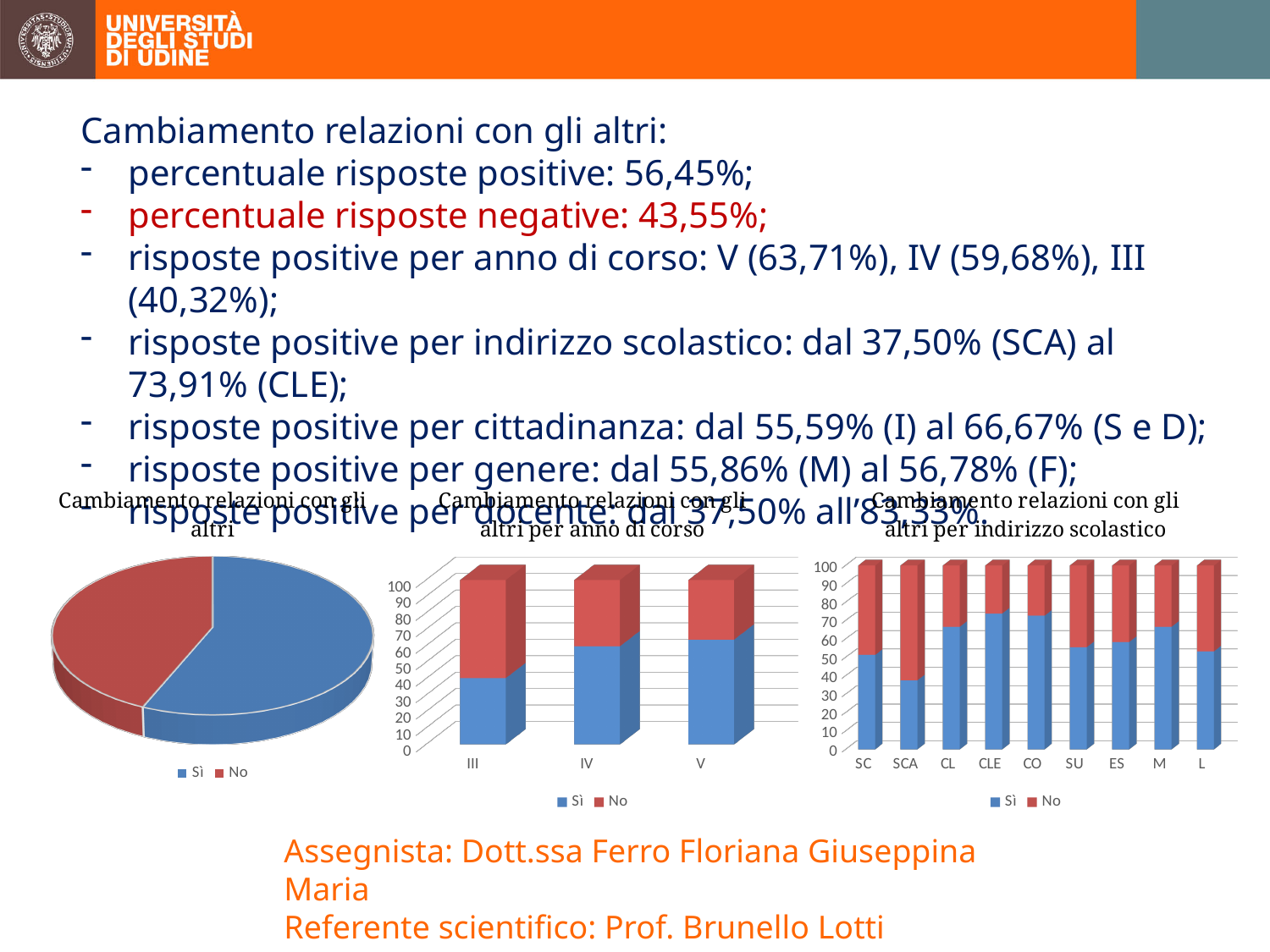
What kind of chart is the middle chart titled 'Cambiamento relazioni con gli altri per anno di corso'? bar chart In the middle chart (per anno di corso), is the 'Sì' value for III greater or less than 50? less What kind of chart is the leftmost chart titled 'Cambiamento relazioni con gli altri'? pie chart How many series does the legend of the rightmost chart (per indirizzo scolastico) list? 2 In the rightmost chart (per indirizzo scolastico), which category has the lowest 'Sì' share? SCA In the middle chart (per anno di corso), how many categories are shown on the x axis? 3 In the middle chart (per anno di corso), which has the larger 'Sì' share, III or IV? IV In the rightmost chart (per indirizzo scolastico), is the 'Sì' value for SCA greater or less than 50? less In the middle chart (per anno di corso), which year has the highest 'Sì' share? V In the rightmost chart (per indirizzo scolastico), how many categories are shown on the x axis? 9 In the leftmost pie chart, which slice is larger, 'Sì' or 'No'? Sì In the middle chart (per anno di corso), is the 'Sì' value for V greater or less than 50? greater